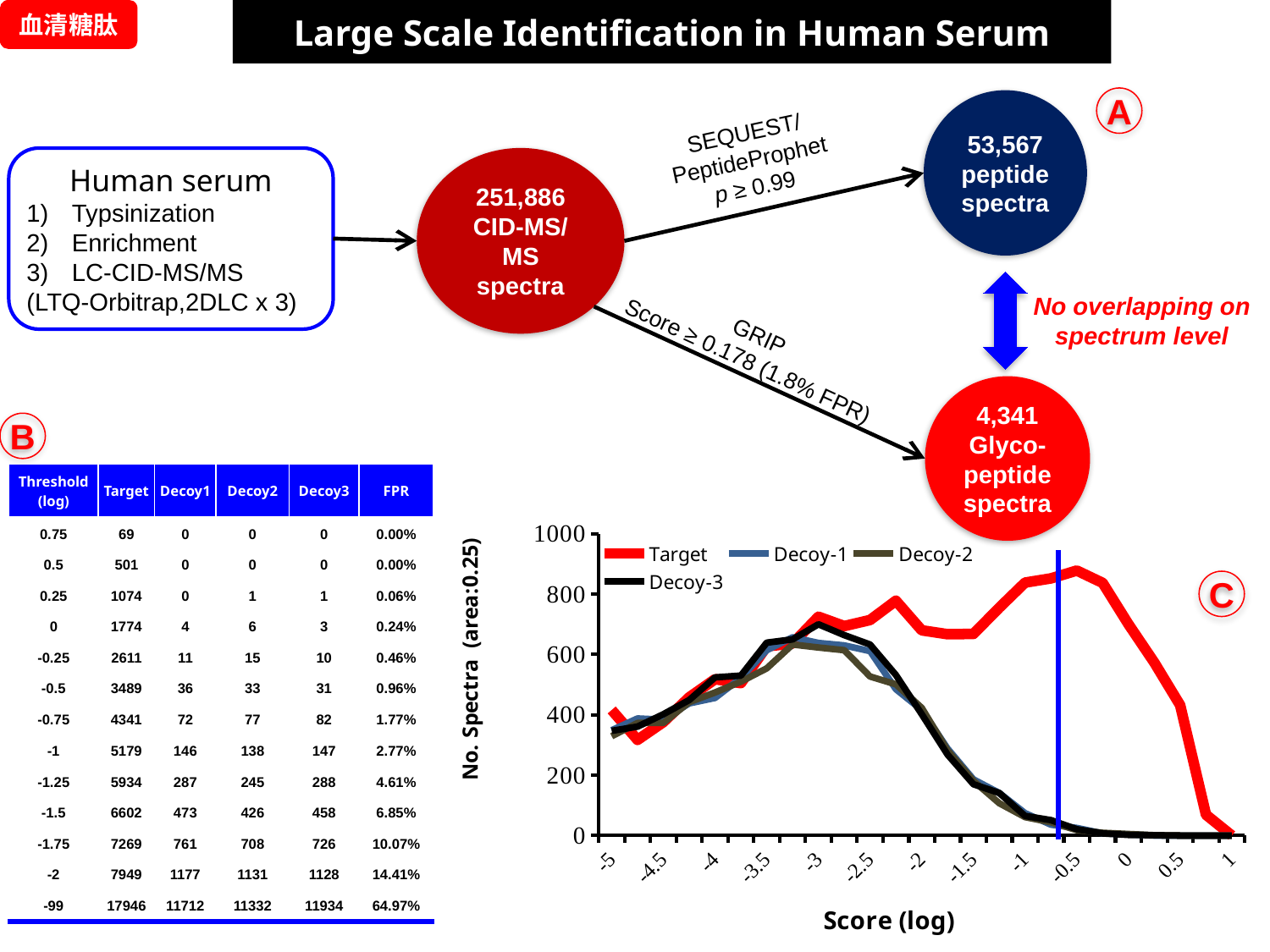
How many series does the legend of chart C list? 4 In chart C, which series reaches the highest value on the chart? Target In chart C, is the value of the Decoy-3 series at a score of -3 greater or less than 600? greater In chart C, does the Target series rise or fall as the score goes from -0.5 to 1? fall In chart C, at a score of -1, which series has the larger value, Target or Decoy-3? Target In chart C, is the value of the Decoy-3 series at a score of -1 greater or less than 400? less What is the y-axis title of chart C? No. Spectra (area:0.25) In chart C, does the Decoy-3 series rise or fall as the score goes from -3 to -1? fall In chart C, is the value of the Target series at a score of 1 greater or less than 200? less What kind of chart is chart C on the slide? line chart What is the x-axis title of chart C? Score (log)